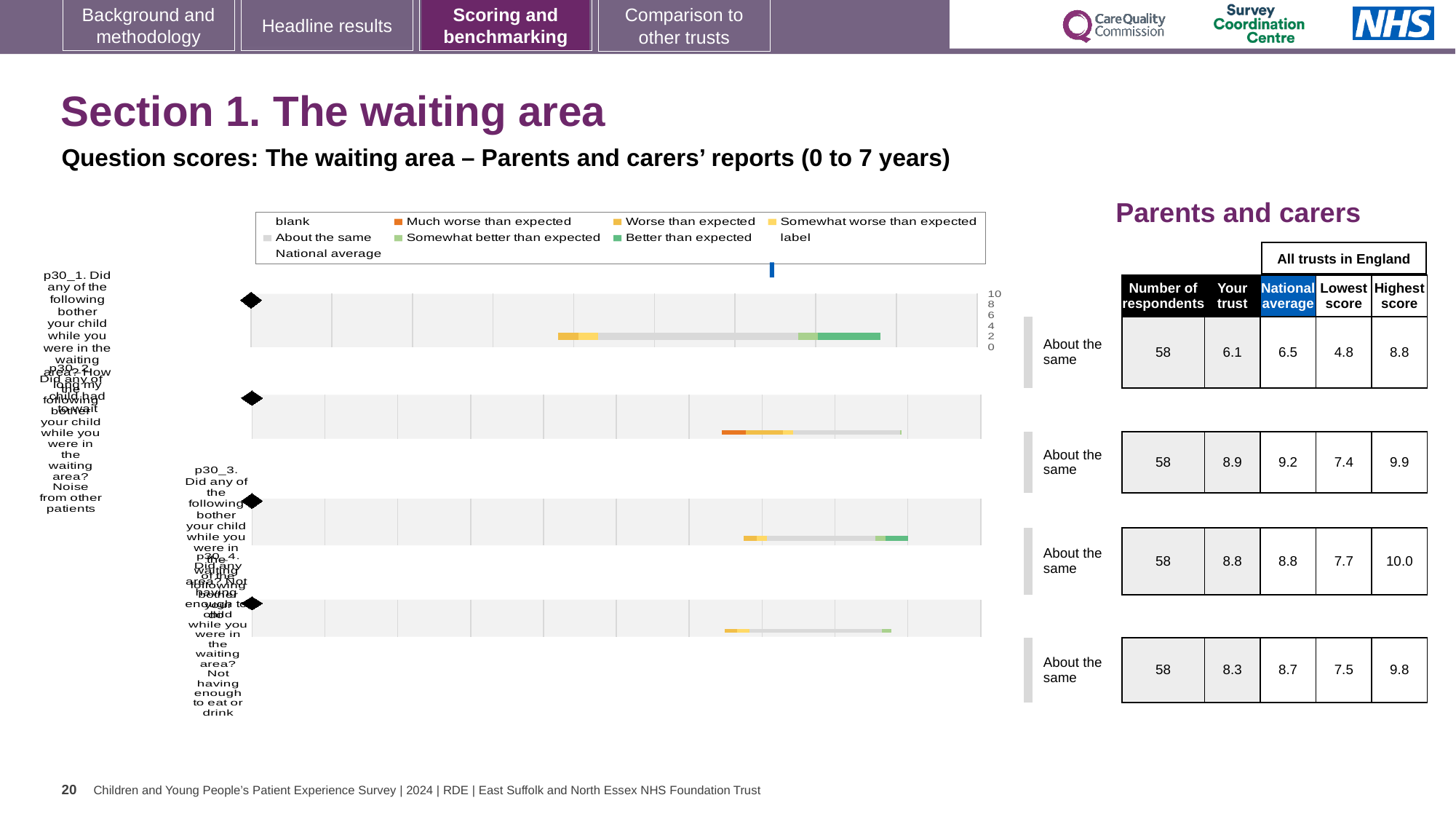
In the table beside the chart, what is the lowest score for the fourth row (p30_4)? 7.5 In the table beside the chart, what is the highest score for the third row (p30_3)? 10.0 How many entries does the chart legend list? 9 Which legend entry is shown in dark green? Better than expected Which colour represents 'Much worse than expected' in the chart legend? orange How many bars (question rows) does the chart contain? 4 In the table beside the chart, which row has the lowest 'Your trust' score? the first row (p30_1), 6.1 In the table beside the chart, what is the difference between the national average and 'Your trust' score for the fourth row (p30_4)? 0.4 In the table beside the chart, what is the 'Your trust' score for the first row (p30_1)? 6.1 In the table beside the chart, what is the national average for the second row (p30_2)? 9.2 What kind of chart is shown on the slide? bar chart In the table beside the chart, how many respondents are listed for each row? 58